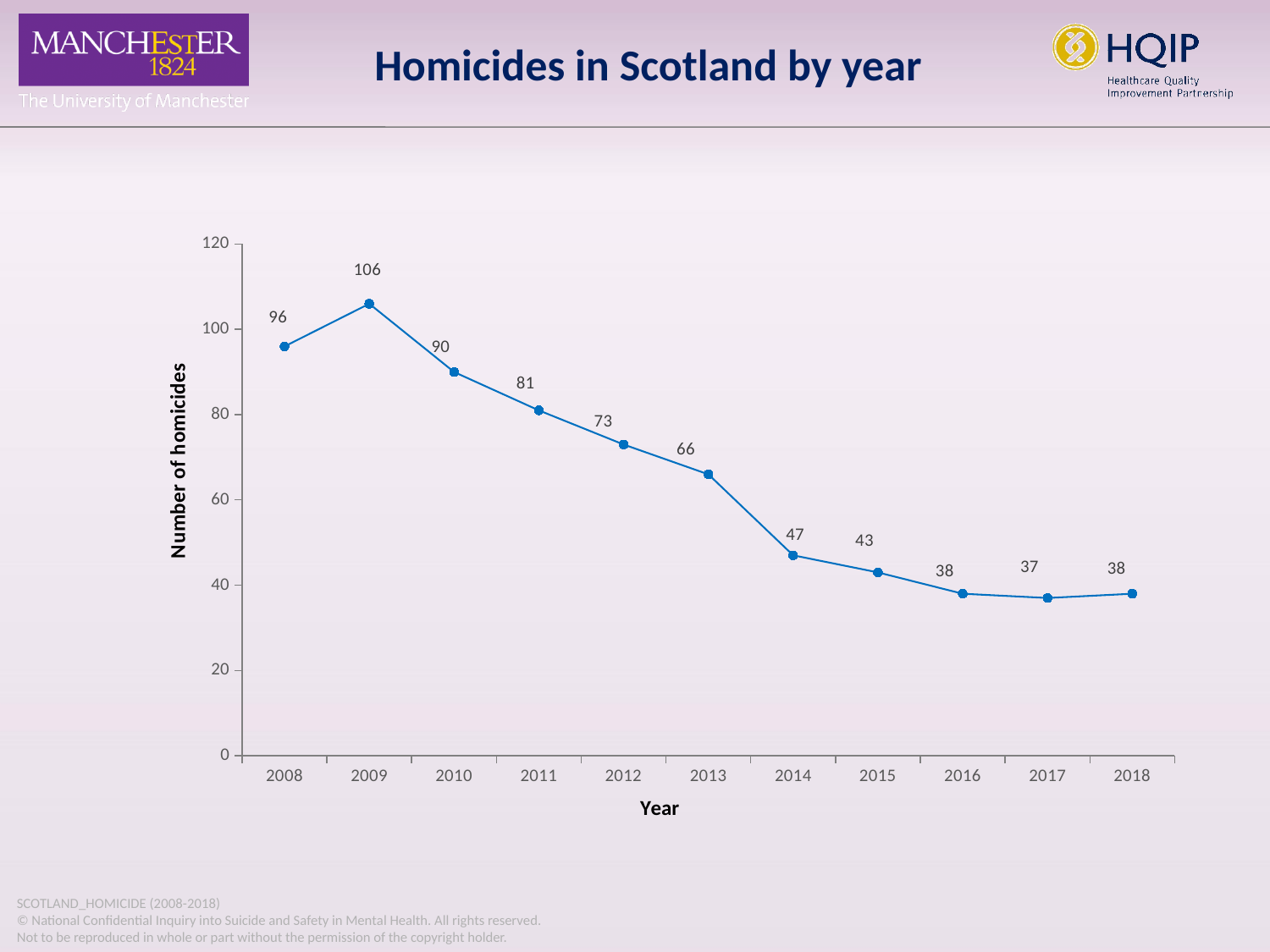
What is the difference in the number of homicides between 2013 and 2014? 19 Which year has the lowest number of homicides? 2017 Which year has the highest number of homicides? 2009 What is the number of homicides in Scotland in 2014? 47 Which year had more homicides, 2010 or 2012? 2010 What is the overall trend in the number of homicides from 2009 to 2017? Falling What is the number of homicides in Scotland in 2017? 37 What kind of chart is shown on the slide? Line chart How many years are plotted on the chart? 11 What is the difference in the number of homicides between 2009 and 2018? 68 What is the number of homicides in Scotland in 2009? 106 Is the number of homicides in 2011 greater or less than 80? greater